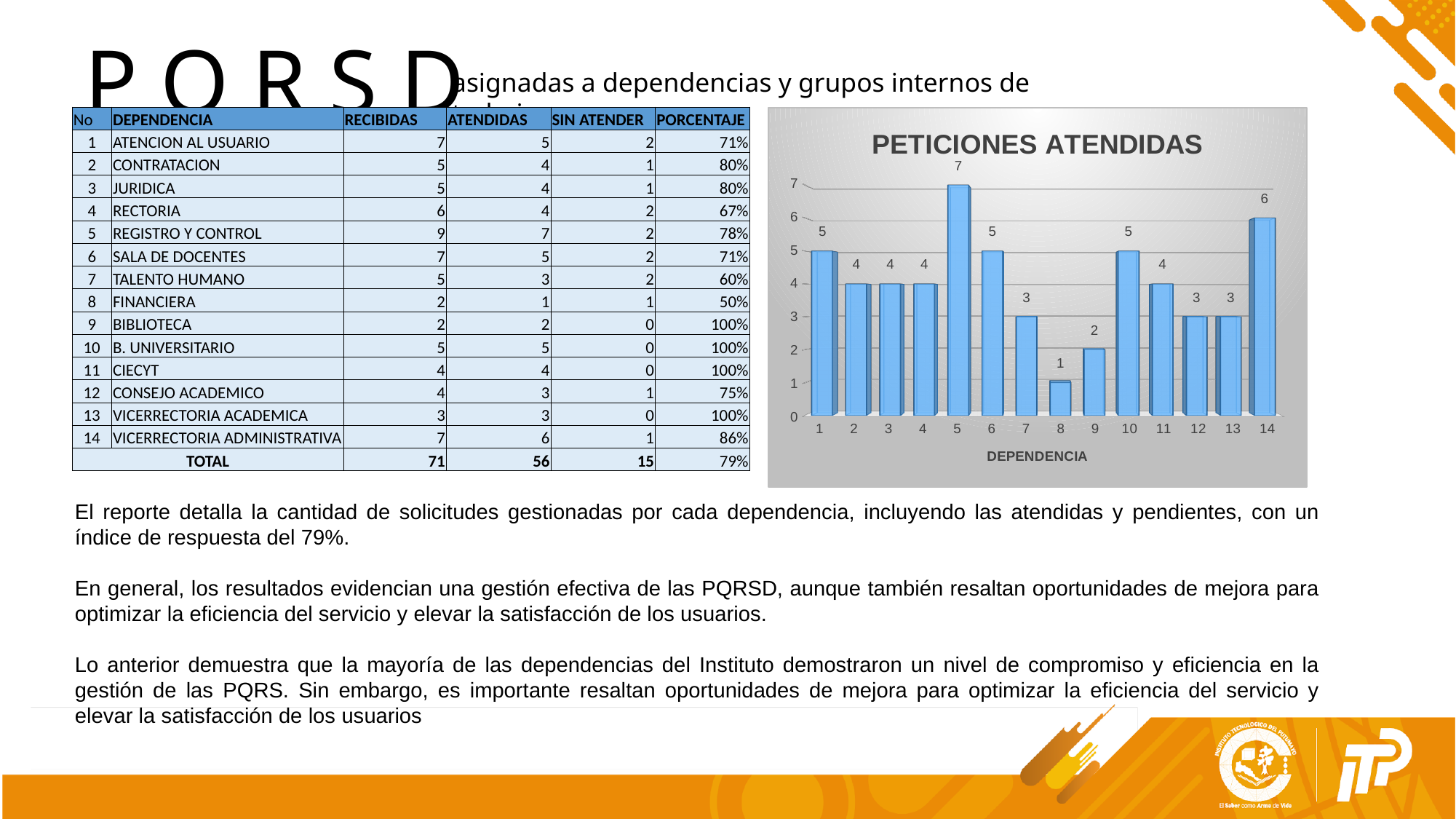
What is the value for dependencia 14 in the chart? 6 What is the value for dependencia 5 in the chart? 7 What is the value for dependencia 8 in the chart? 1 Which dependencia has the highest value in the chart? 5 What type of chart is shown on the slide? bar chart What is the x axis title of the chart? DEPENDENCIA What is the difference between the values for dependencia 5 and dependencia 8? 6 What is the difference between the values for dependencia 14 and dependencia 13? 3 Which has a larger value, dependencia 9 or dependencia 10? 10 Which dependencia has the lowest value in the chart? 8 How many categories are plotted on the x axis of the chart? 14 What is the title of the chart? PETICIONES ATENDIDAS